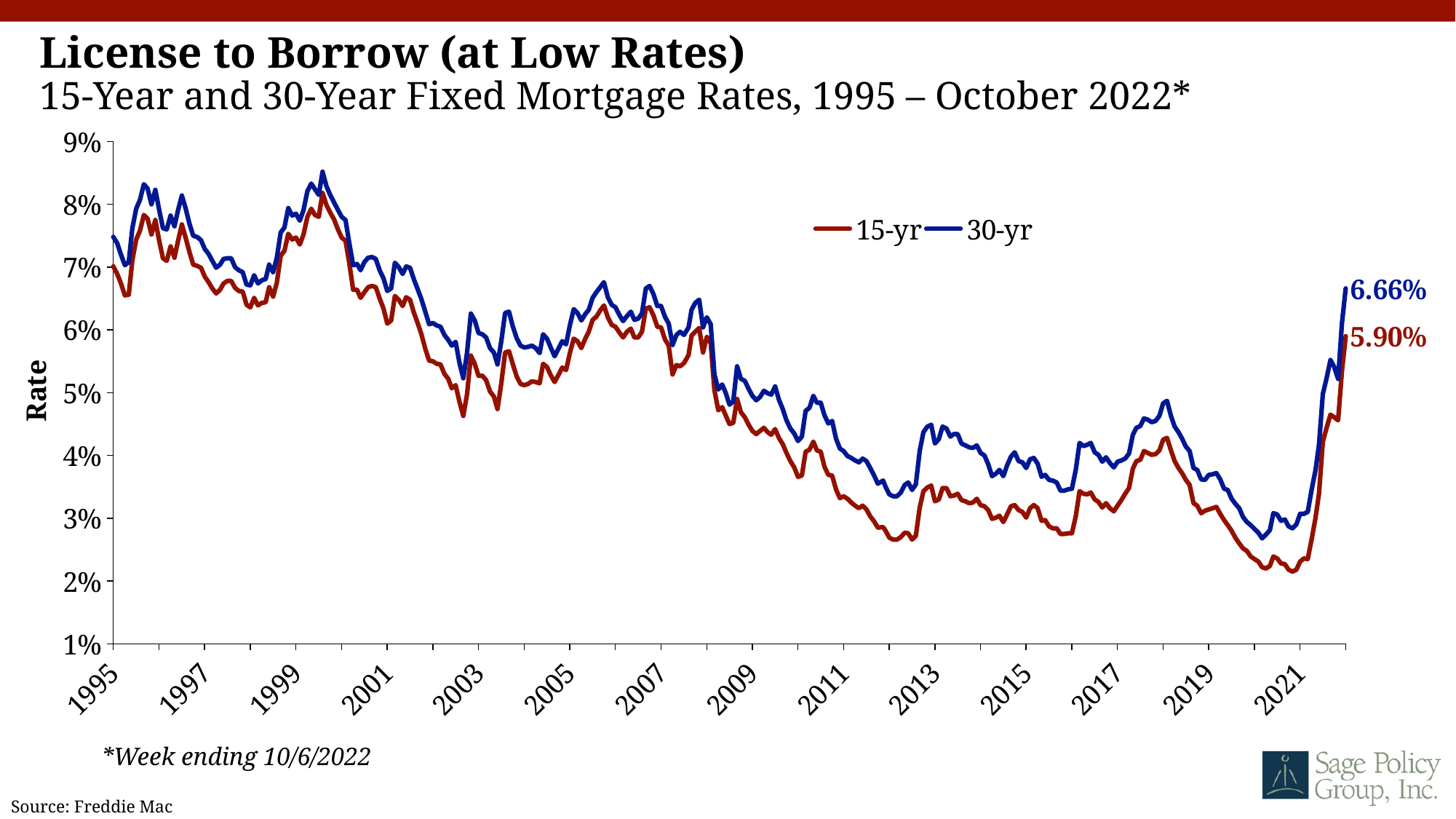
What kind of chart is shown on the slide? Line chart What is the final labeled value of the 15-yr series? 5.90% How many series does the legend list? 2 Overall, from 1995 to 2021, do the mortgage rates rise or fall? fall What is the label on the vertical axis? Rate What is the difference between the final labeled 30-yr rate and the final labeled 15-yr rate? 0.76% At the end of the series, which is higher, the 30-yr rate or the 15-yr rate? 30-yr Is the 15-yr rate around 2021 greater or less than 3%? less What is the final labeled value of the 30-yr series? 6.66% Is the 30-yr rate in 2013 greater or less than 5%? less What colour is the 30-yr line? Blue Is the 30-yr rate at the start of 1995 greater or less than 7%? greater